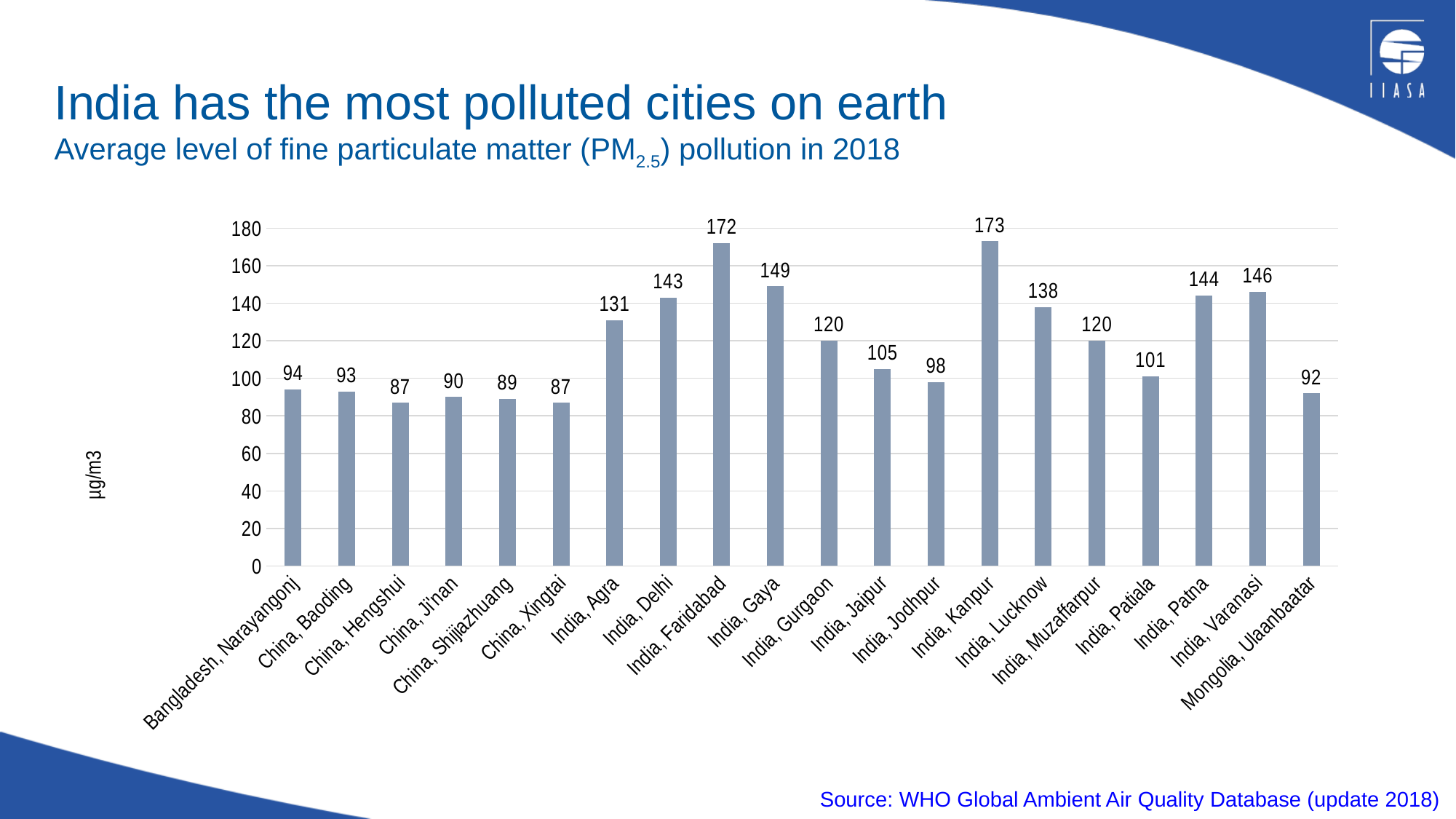
What value is shown for Mongolia, Ulaanbaatar? 92 What is the PM2.5 level shown for India, Delhi? 143 What is the difference between the values for India, Varanasi and India, Patna? 2 Which has a higher value, India, Gaya or India, Lucknow? India, Gaya What is the difference between the values for India, Faridabad and India, Agra? 41 How many cities are shown in the chart? 20 Which has a lower value, China, Baoding or Bangladesh, Narayangonj? China, Baoding Is the value for India, Jaipur greater or less than 100? greater What unit is shown on the vertical axis of the chart? µg/m3 Which city has the highest PM2.5 level in the chart? India, Kanpur What is the value for China, Shijiazhuang? 89 What type of chart is shown on the slide? Bar chart